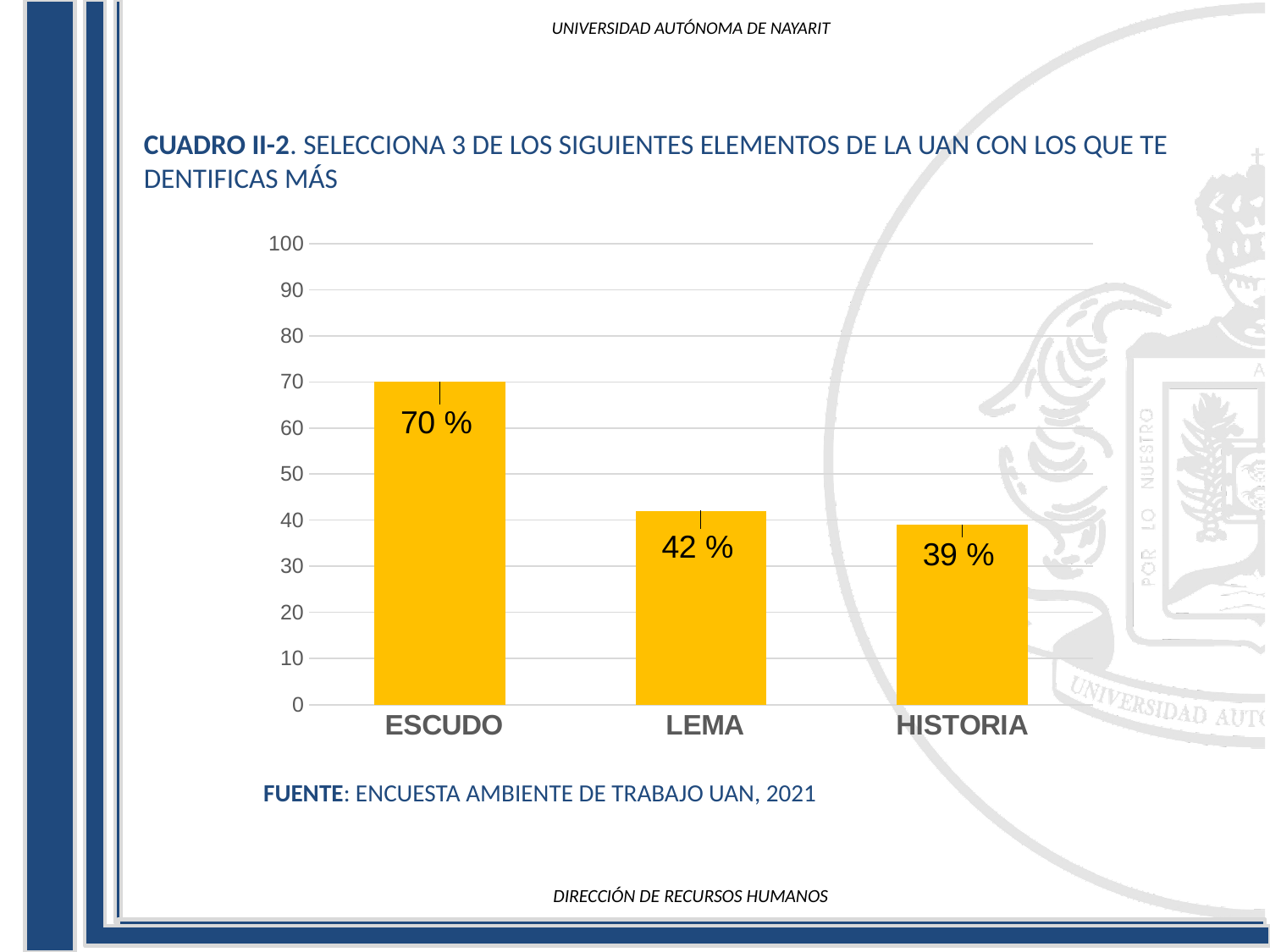
How many categories are shown on the x axis? 3 Is the value for ESCUDO greater or less than 60? greater What is the value for HISTORIA? 39 % What is the value for ESCUDO? 70 % Do the values rise or fall from left to right along the x axis? fall What is the value for LEMA? 42 % What is the difference between the values for LEMA and HISTORIA? 3 % Which category has the highest value? ESCUDO Which is larger, the value for ESCUDO or the value for HISTORIA? ESCUDO What is the difference between the values for ESCUDO and LEMA? 28 % Which category has the lowest value? HISTORIA What kind of chart is shown on the slide? bar chart